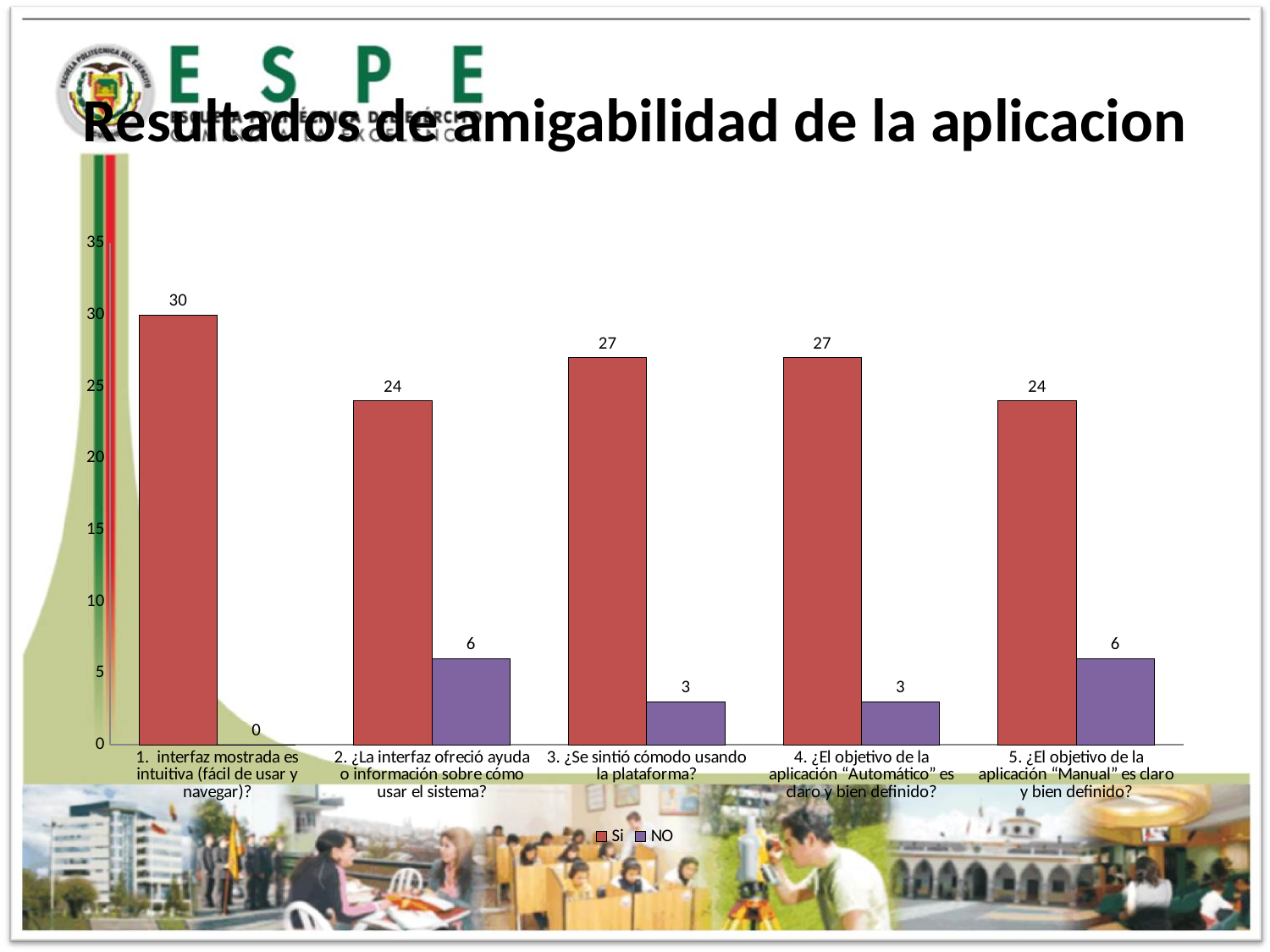
What is the 'NO' value for question 1 (interfaz mostrada es intuitiva)? 0 Which question has the lowest 'NO' value? 1. interfaz mostrada es intuitiva (fácil de usar y navegar)? Which is larger: the 'NO' value for question 2 or the 'NO' value for question 3? Question 2 Is the 'Si' value for question 4 greater or less than 25? greater What is the 'Si' value for question 1 (interfaz mostrada es intuitiva)? 30 What kind of chart is shown on the slide? Bar chart How many series does the legend list? 2 Which question has the highest 'Si' value? 1. interfaz mostrada es intuitiva (fácil de usar y navegar)? What is the difference between the 'Si' and 'NO' values for question 5 (¿El objetivo de la aplicación “Manual” es claro y bien definido?)? 18 What is the 'NO' value for question 2 (¿La interfaz ofreció ayuda o información sobre cómo usar el sistema?)? 6 What is the 'Si' value for question 3 (¿Se sintió cómodo usando la plataforma?)? 27 How many questions (categories) are shown on the x axis? 5